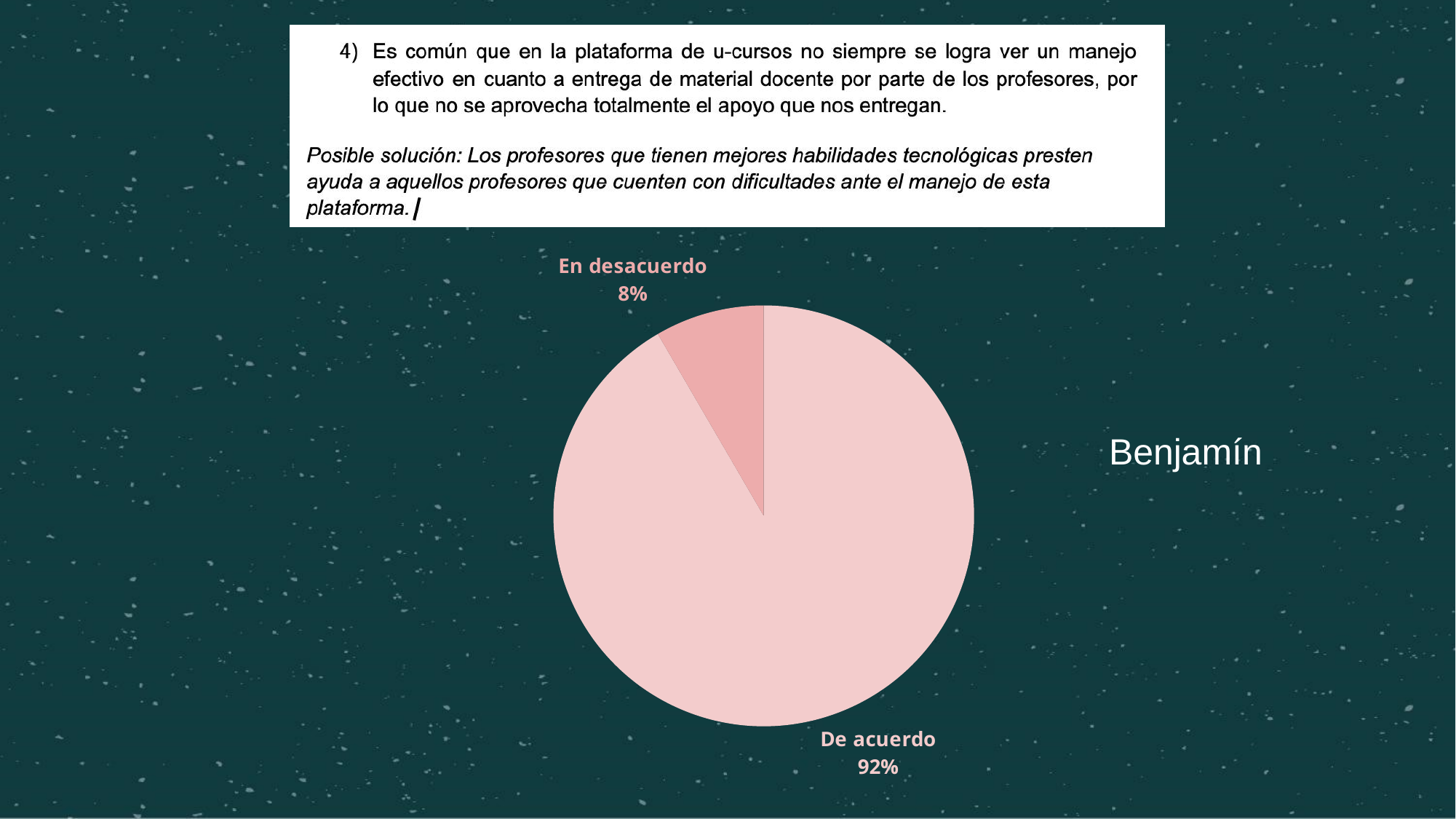
What percentage of the pie chart is labelled "En desacuerdo"? 8% How many slices does the pie chart have? 2 Which slice of the pie chart is the largest? De acuerdo What share of the pie does the "En desacuerdo" slice represent? 8% What name appears to the right of the pie chart? Benjamín What kind of chart is shown on the slide? Pie chart What is the difference in percentage points between the "De acuerdo" and "En desacuerdo" slices? 84 Which slice of the pie chart is the smallest? En desacuerdo Which slice of the pie chart is drawn in the darker pink shade? En desacuerdo What percentage of the pie chart is labelled "De acuerdo"? 92% Which slice is larger, "De acuerdo" or "En desacuerdo"? De acuerdo What is the total of the two percentages shown on the pie chart? 100%